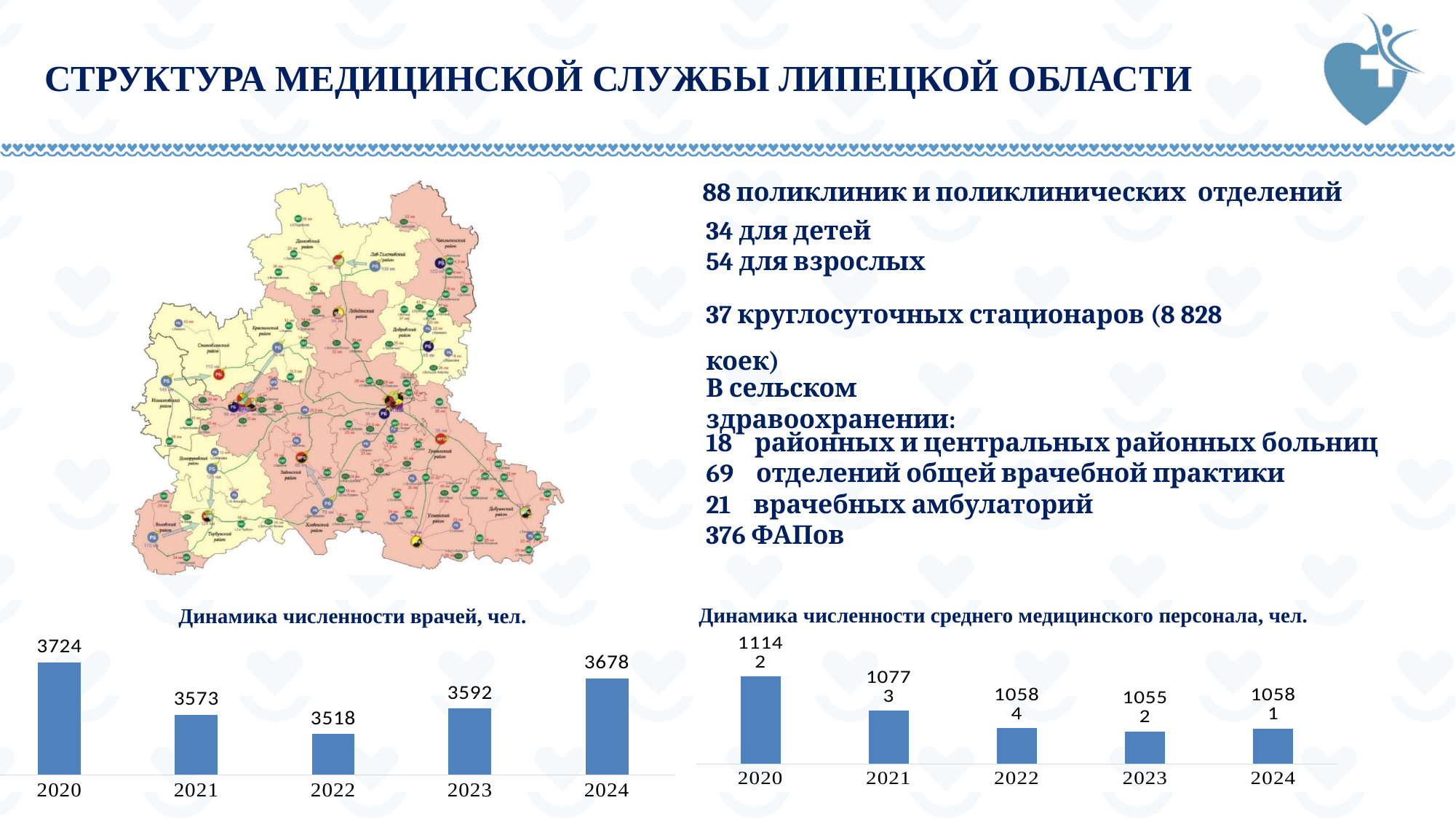
In the chart 'Динамика численности среднего медицинского персонала, чел.', what is the value for 2023? 10552 In the chart 'Динамика численности врачей, чел.', which year has the highest value? 2020 What type of chart is 'Динамика численности врачей, чел.'? bar chart In the chart 'Динамика численности среднего медицинского персонала, чел.', what is the value for 2020? 11142 In the chart 'Динамика численности врачей, чел.', which year has the lowest value? 2022 In the chart 'Динамика численности врачей, чел.', how many years are shown on the x axis? 5 In the chart 'Динамика численности врачей, чел.', what is the difference between the values for 2024 and 2023? 86 In the chart 'Динамика численности среднего медицинского персонала, чел.', is the value for 2021 larger or smaller than the value for 2022? larger In the chart 'Динамика численности среднего медицинского персонала, чел.', which year has the highest value? 2020 In the chart 'Динамика численности среднего медицинского персонала, чел.', what is the difference between the values for 2020 and 2021? 369 In the chart 'Динамика численности врачей, чел.', what is the value for 2022? 3518 In the chart 'Динамика численности врачей, чел.', what is the value for 2020? 3724